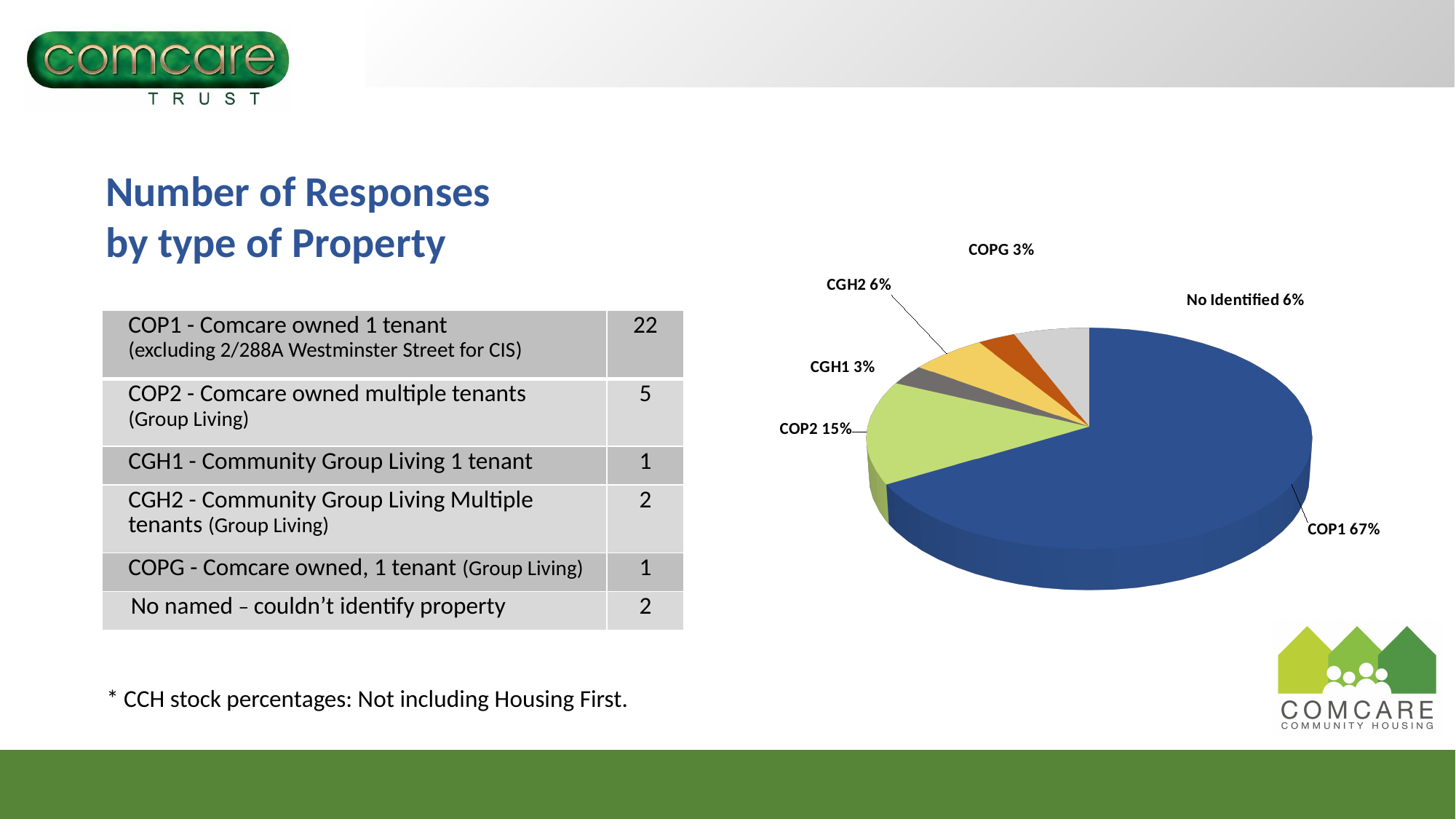
What share of the pie chart does COP2 represent? 15% What is the difference in percentage points between the COP1 and COP2 slices? 52 Which slice is larger on the pie chart, COP2 or CGH2? COP2 What share of the pie chart does COP1 represent? 67% Which slice is larger on the pie chart, CGH1 or No Identified? No Identified What type of chart is shown on the slide? Pie chart What colour is the COP1 slice of the pie chart? Blue What percentage is shown for No Identified on the pie chart? 6% How many slices does the pie chart have? 6 What percentage is shown for CGH2 on the pie chart? 6% Which category has the largest slice of the pie chart? COP1 What percentage is shown for COPG on the pie chart? 3%